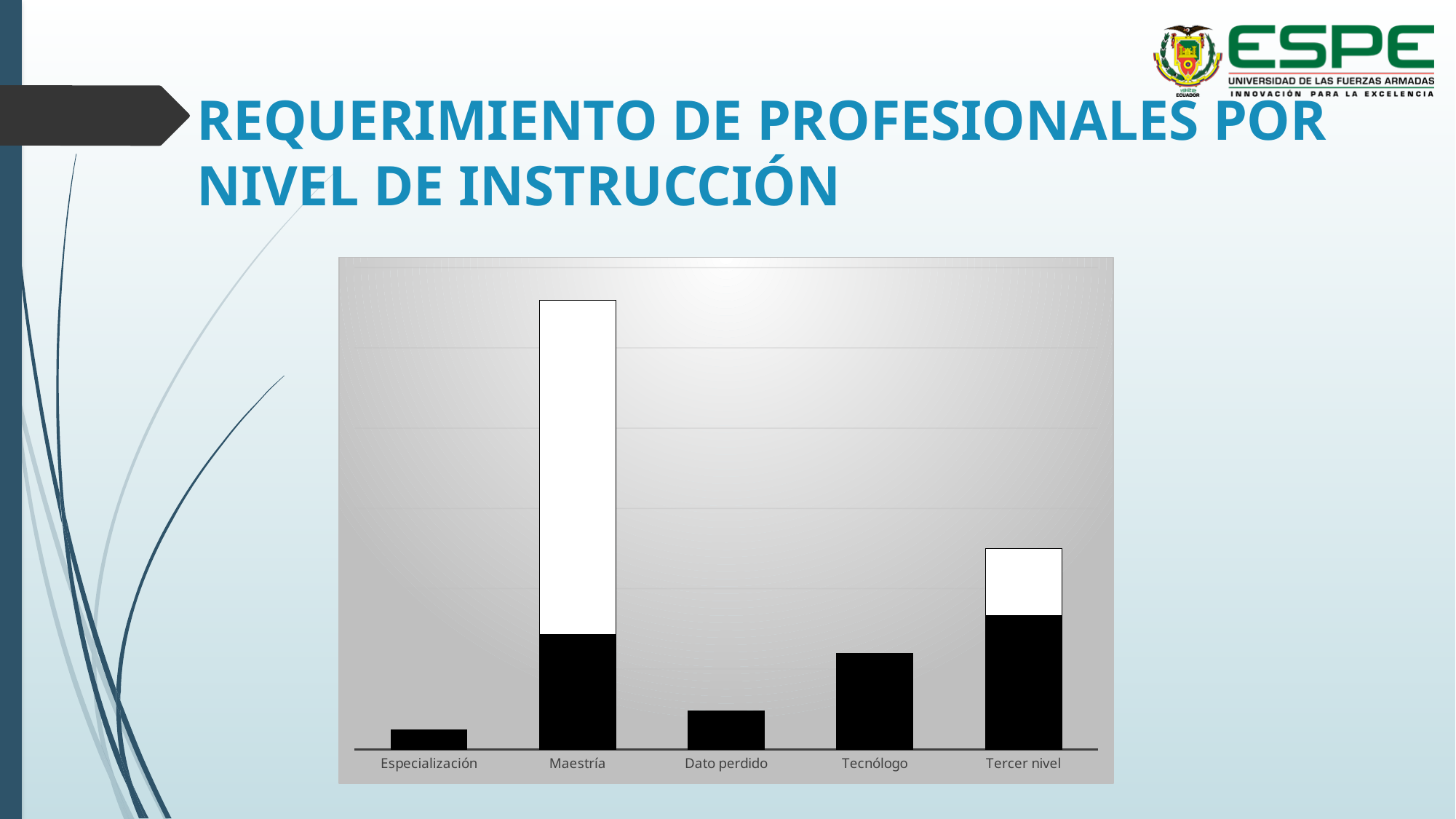
What is the title of the slide containing the chart? REQUERIMIENTO DE PROFESIONALES POR NIVEL DE INSTRUCCIÓN What kind of chart is shown on the slide? bar chart Which bar is taller, Especialización or Dato perdido? Dato perdido Which bar is taller, Tercer nivel or Tecnólogo? Tercer nivel Which category has the tallest bar in the chart? Maestría How many categories are shown on the x axis of the chart? 5 Which bar is taller, Tecnólogo or Dato perdido? Tecnólogo How many bars in the chart include a white segment on top of the black segment? 2 Which category is the leftmost on the x axis of the chart? Especialización Which category has the shortest bar in the chart? Especialización